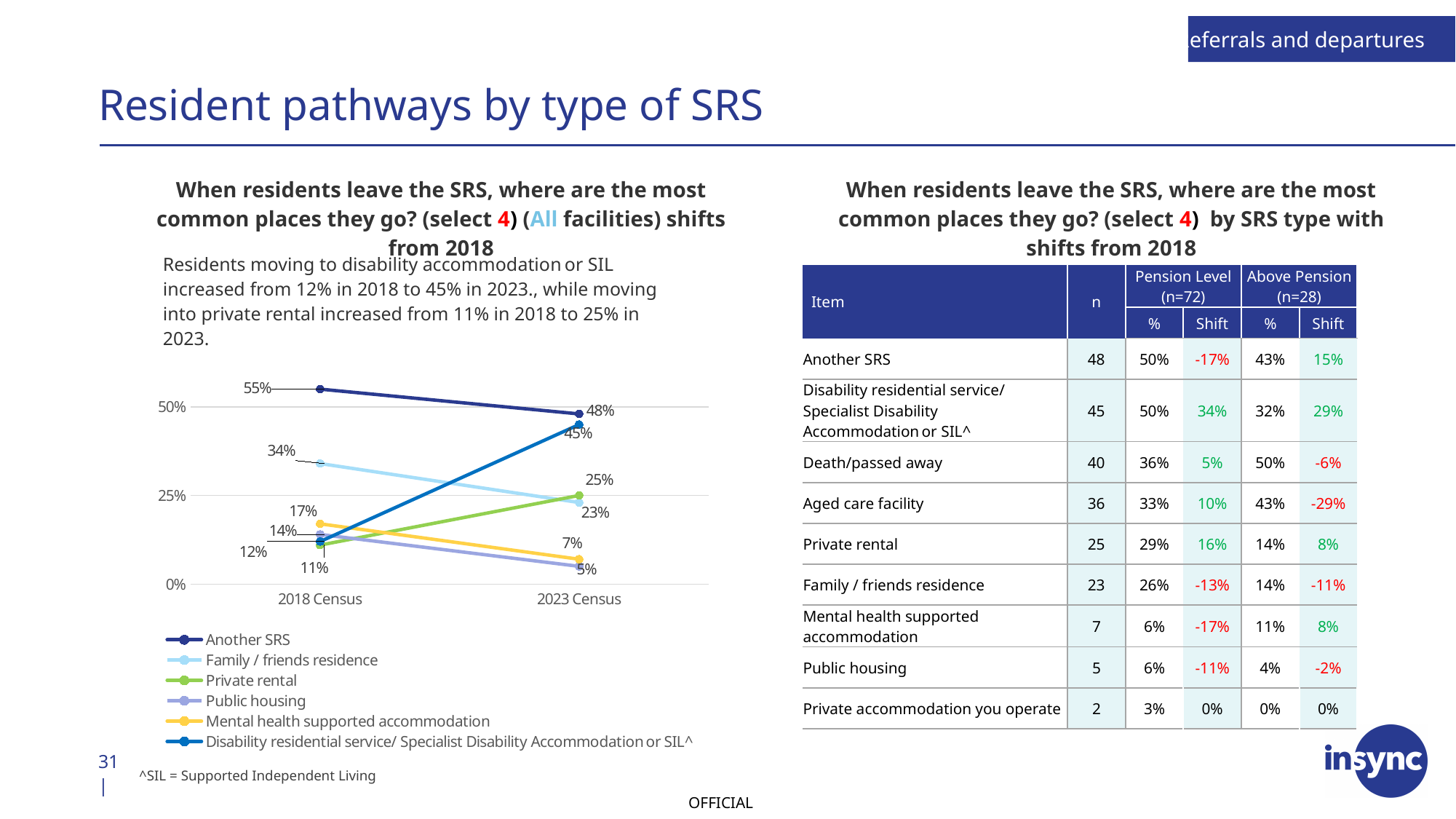
Which series has the lowest value at the 2023 Census? Public housing Does the value for Family / friends residence rise or fall from the 2018 Census to the 2023 Census? Fall Which is larger at the 2023 Census: Another SRS or Private rental? Another SRS How many census points are shown on the x axis of the chart? 2 What is the value for Family / friends residence at the 2023 Census? 23% What type of chart is shown on the slide? Line chart By how much did the value for Private rental change from the 2018 Census (11%) to the 2023 Census (25%)? 14 percentage points What is the value for Disability residential service/ Specialist Disability Accommodation or SIL at the 2023 Census? 45% What is the value for Another SRS at the 2018 Census? 55% What is the value for Mental health supported accommodation at the 2023 Census? 7% Which series has the highest value at the 2018 Census? Another SRS How many series does the chart legend list? 6